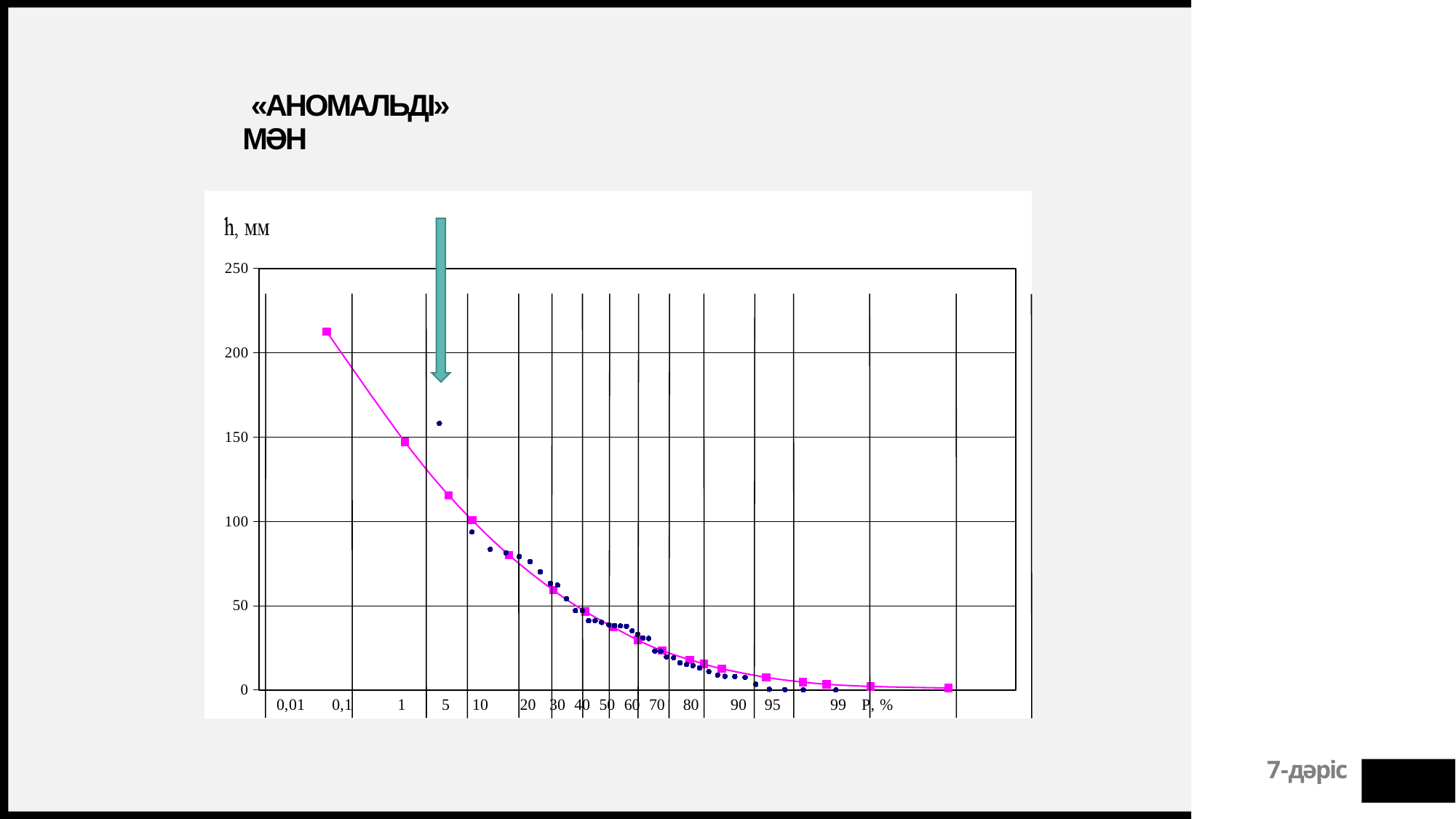
Is the value of the curve at P = 50 greater or less than 50? less What is the label of the horizontal axis of the chart? P, % Is the value of the curve at P = 5 greater or less than 100? greater What is the maximum value shown on the vertical axis? 250 Is the value of the outlier point marked by the arrow (at P = 5) greater or less than 100? greater What kind of chart is shown on the slide? line chart Which is larger, the value of the curve at P = 10 or at P = 70? P = 10 Does the plotted curve rise or fall as P, % increases along the x axis? fall What is the label of the vertical axis of the chart? h, мм How many tick labels are printed on the horizontal axis? 15